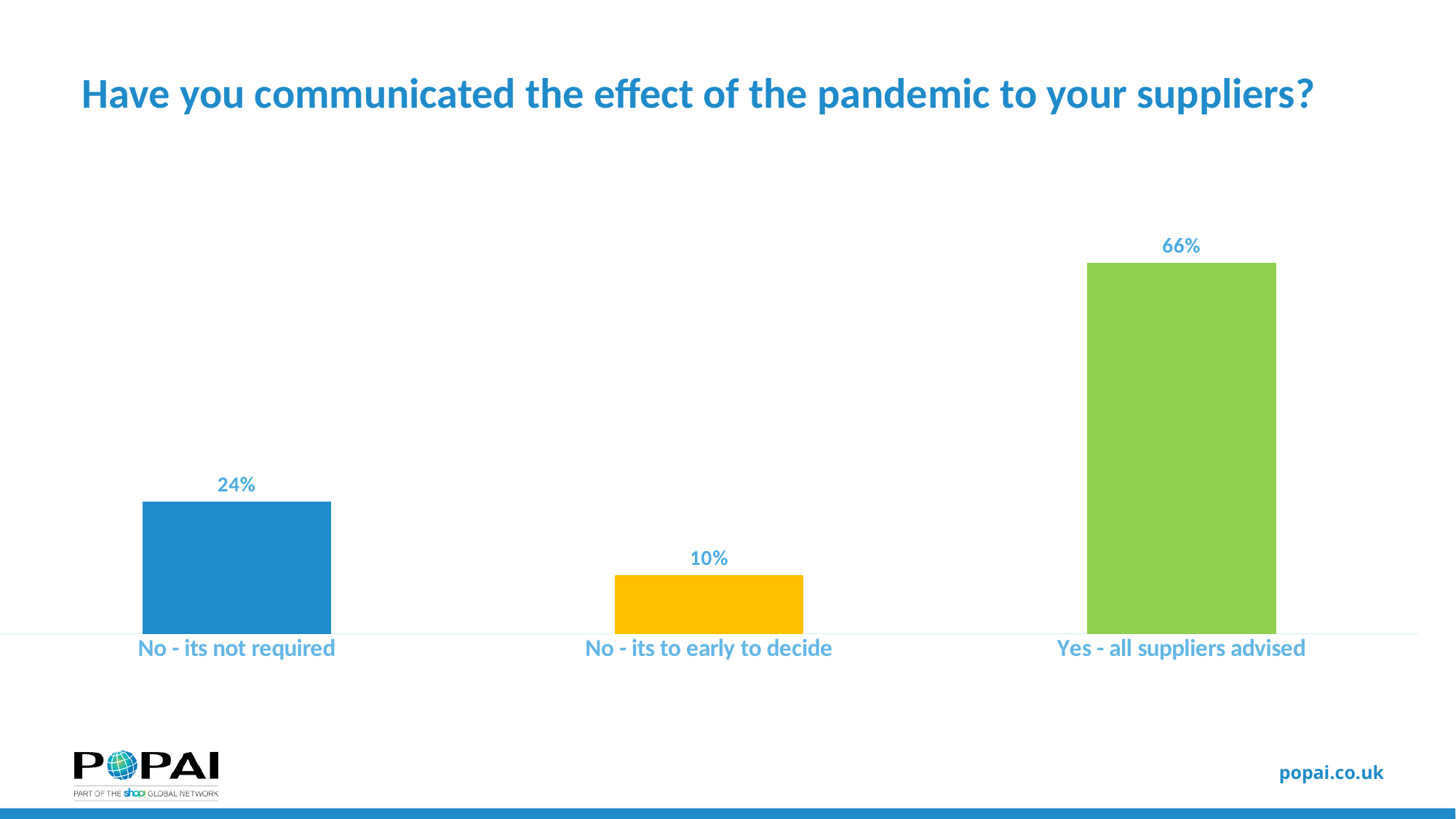
Which response has the lowest percentage? No - its to early to decide Which response has the highest percentage? Yes - all suppliers advised What type of chart is shown on the slide? Bar chart What percentage of respondents answered "Yes - all suppliers advised"? 66% What is the difference in percentage points between "No - its not required" and "No - its to early to decide"? 14 Which is larger: the value for "No - its not required" or the value for "No - its to early to decide"? No - its not required What is the difference in percentage points between "Yes - all suppliers advised" and "No - its not required"? 42 How many response categories are shown in the chart? 3 What colour is the bar for "Yes - all suppliers advised"? Green What percentage of respondents answered "No - its to early to decide"? 10% What is the title of the chart? Have you communicated the effect of the pandemic to your suppliers? What percentage of respondents answered "No - its not required"? 24%